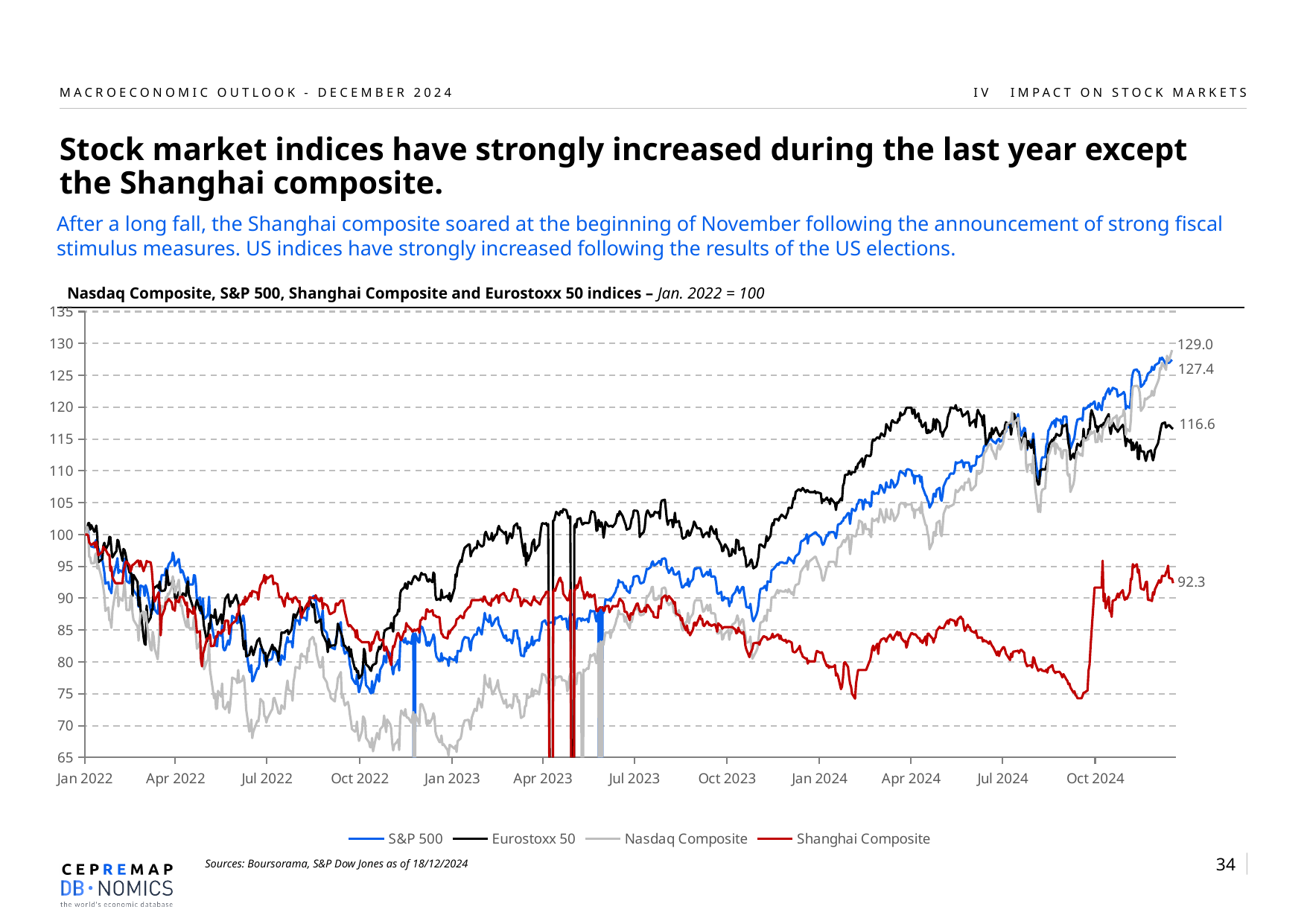
What is the final value shown for the Eurostoxx 50 series? 116.6 Is the value of the Eurostoxx 50 around Apr 2024 greater or less than 115? greater What is the final value shown for the Shanghai Composite series? 92.3 How many series does the legend list? 4 Did the Shanghai Composite rise or fall between Jan 2022 and Oct 2024? fall What is the difference between the final values of the Eurostoxx 50 (116.6) and the Shanghai Composite (92.3)? 24.3 Which series has the lowest value at the end of the chart? Shanghai Composite At the end of the chart, which is larger: the S&P 500 or the Eurostoxx 50? S&P 500 What kind of chart is shown on the slide? line chart What base period is the index set to 100 in the chart title? Jan. 2022 What is the highest end-of-series value labelled on the chart? 129.0